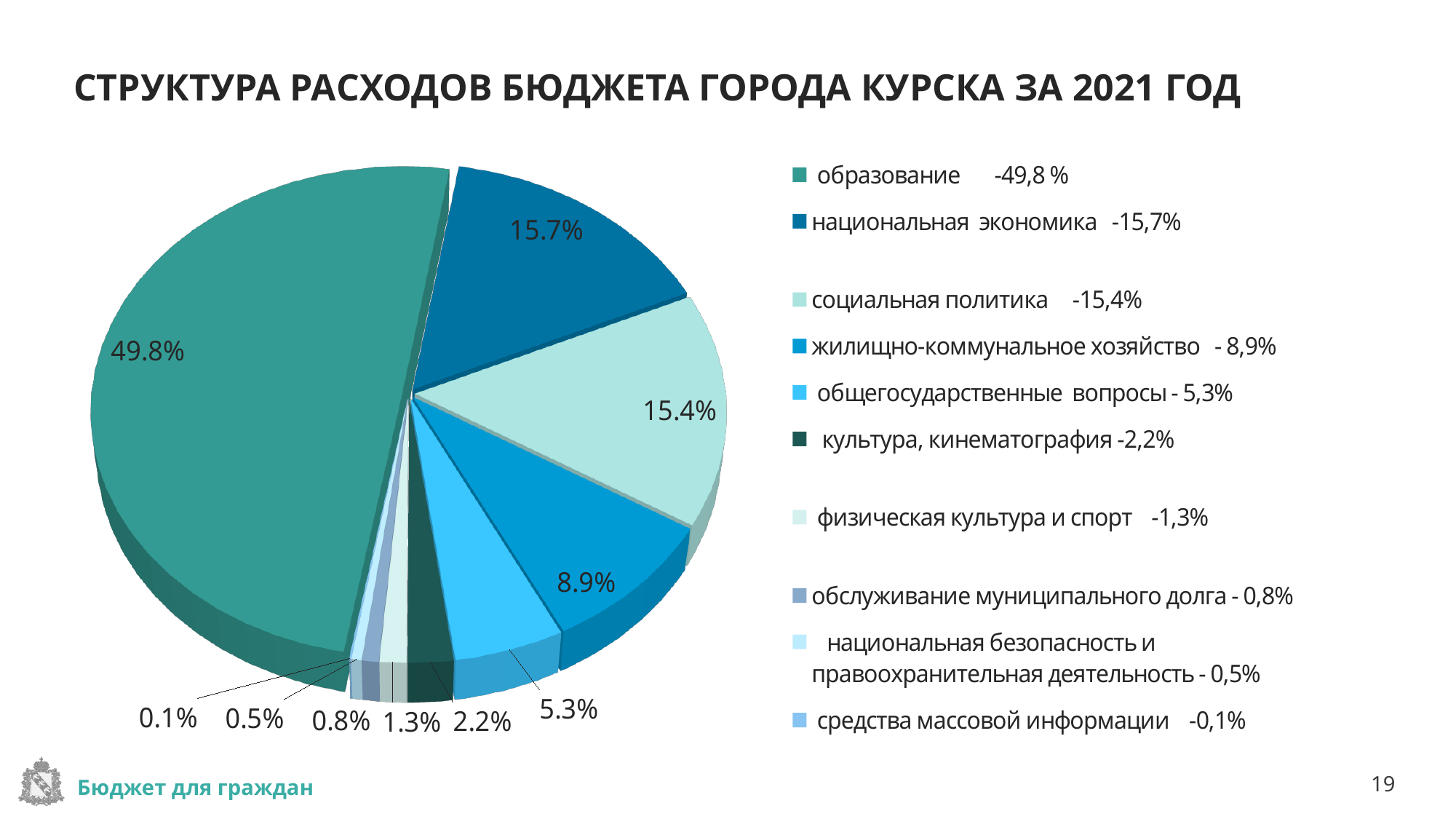
What is the value shown for жилищно-коммунальное хозяйство? 8.9% What is the difference in percentage points between образование and национальная экономика? 34.1 What is the value shown for общегосударственные вопросы? 5.3% How many categories does the pie chart have? 10 What is the difference in percentage points between национальная экономика and социальная политика? 0.3 What share of the pie does национальная экономика have? 15.7% What is the value shown for культура, кинематография? 2.2% Which is larger: социальная политика or жилищно-коммунальное хозяйство? социальная политика What kind of chart is shown on the slide? pie chart What is the title of the chart on the slide? СТРУКТУРА РАСХОДОВ БЮДЖЕТА ГОРОДА КУРСКА ЗА 2021 ГОД Which category has the largest share of the pie? образование Which category has the smallest share of the pie? средства массовой информации